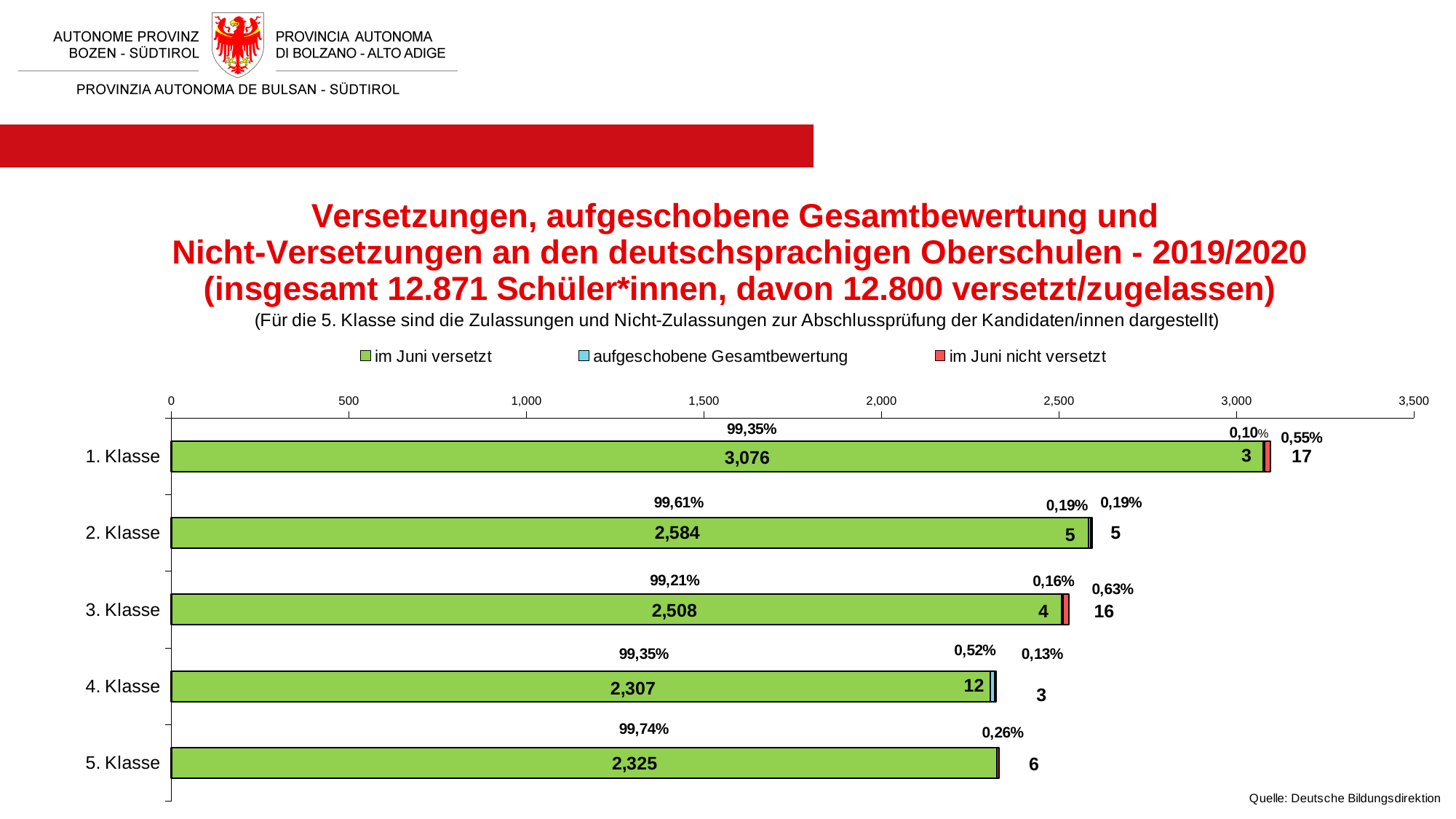
What is the value for 'im Juni nicht versetzt' for 3. Klasse? 16 How many series does the legend list? 3 Which class has the lowest value for 'im Juni versetzt'? 4. Klasse What is the value for 'aufgeschobene Gesamtbewertung' for 4. Klasse? 12 How many classes (categories) are shown on the chart? 5 What percentage is shown for 'im Juni versetzt' for 5. Klasse? 99,74% What is the difference between the 'im Juni versetzt' values for 1. Klasse and 2. Klasse? 492 What is the value for 'im Juni versetzt' for 1. Klasse? 3,076 What type of chart is shown on the slide? bar chart What is the total of the stacked bar for 2. Klasse? 2,594 Which is larger, the 'im Juni nicht versetzt' value for 1. Klasse or for 3. Klasse? 1. Klasse Which class has the highest value for 'im Juni versetzt'? 1. Klasse